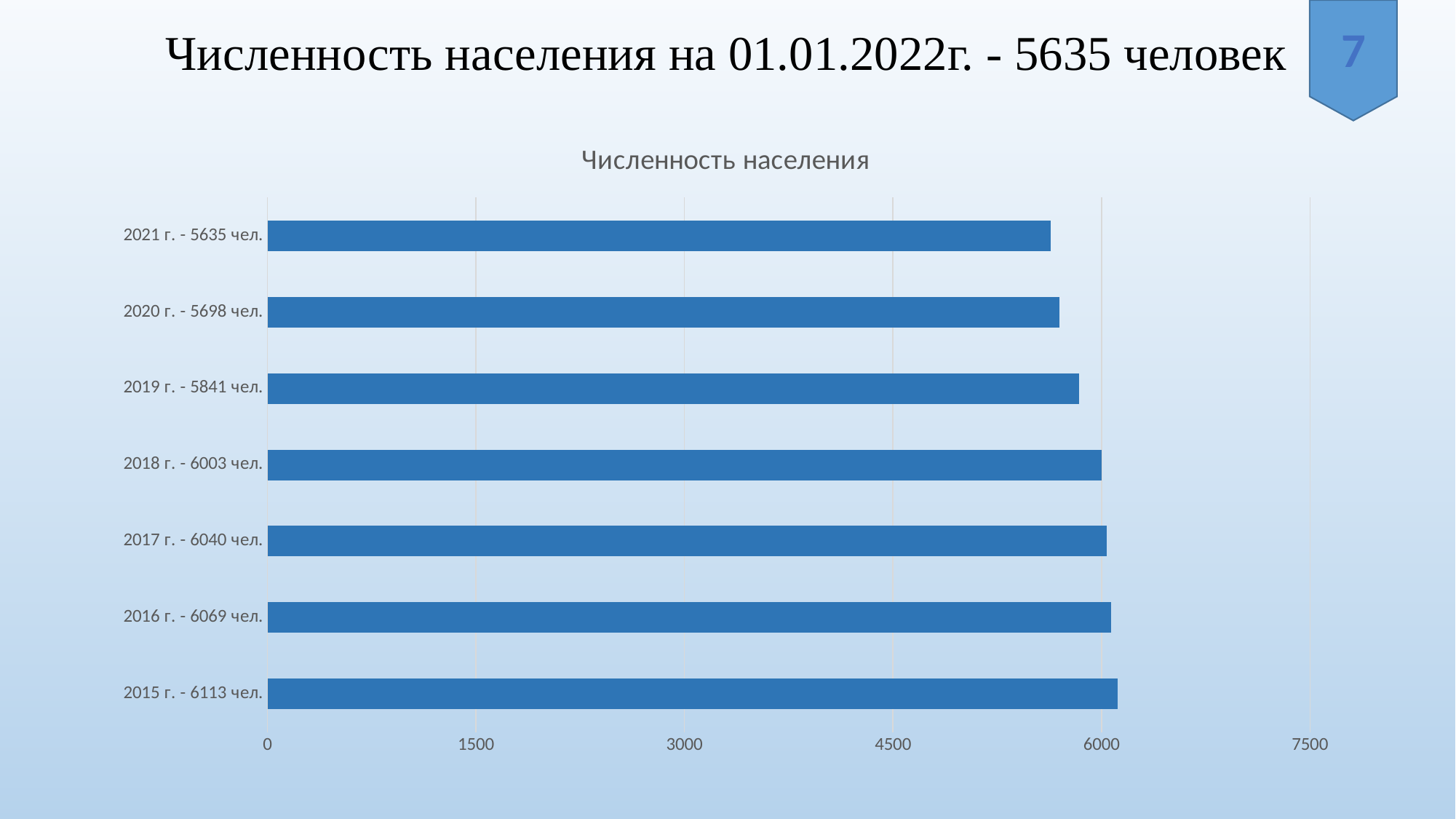
What is the population value shown for 2015 г.? 6113 чел. What is the population value shown for 2021 г.? 5635 чел. What is the difference between the population in 2019 г. and in 2020 г.? 143 What is the population value shown for 2018 г.? 6003 чел. Which year has the highest population in the chart? 2015 г. How many years (bars) are shown in the chart? 7 Which year has the lowest population in the chart? 2021 г. What is the difference between the population in 2015 г. and in 2021 г.? 478 What is the title of the chart? Численность населения Is the value for 2021 г. greater or less than 6000? less What kind of chart is shown on the slide? bar chart Which is larger, the population in 2018 г. or in 2019 г.? 2018 г.